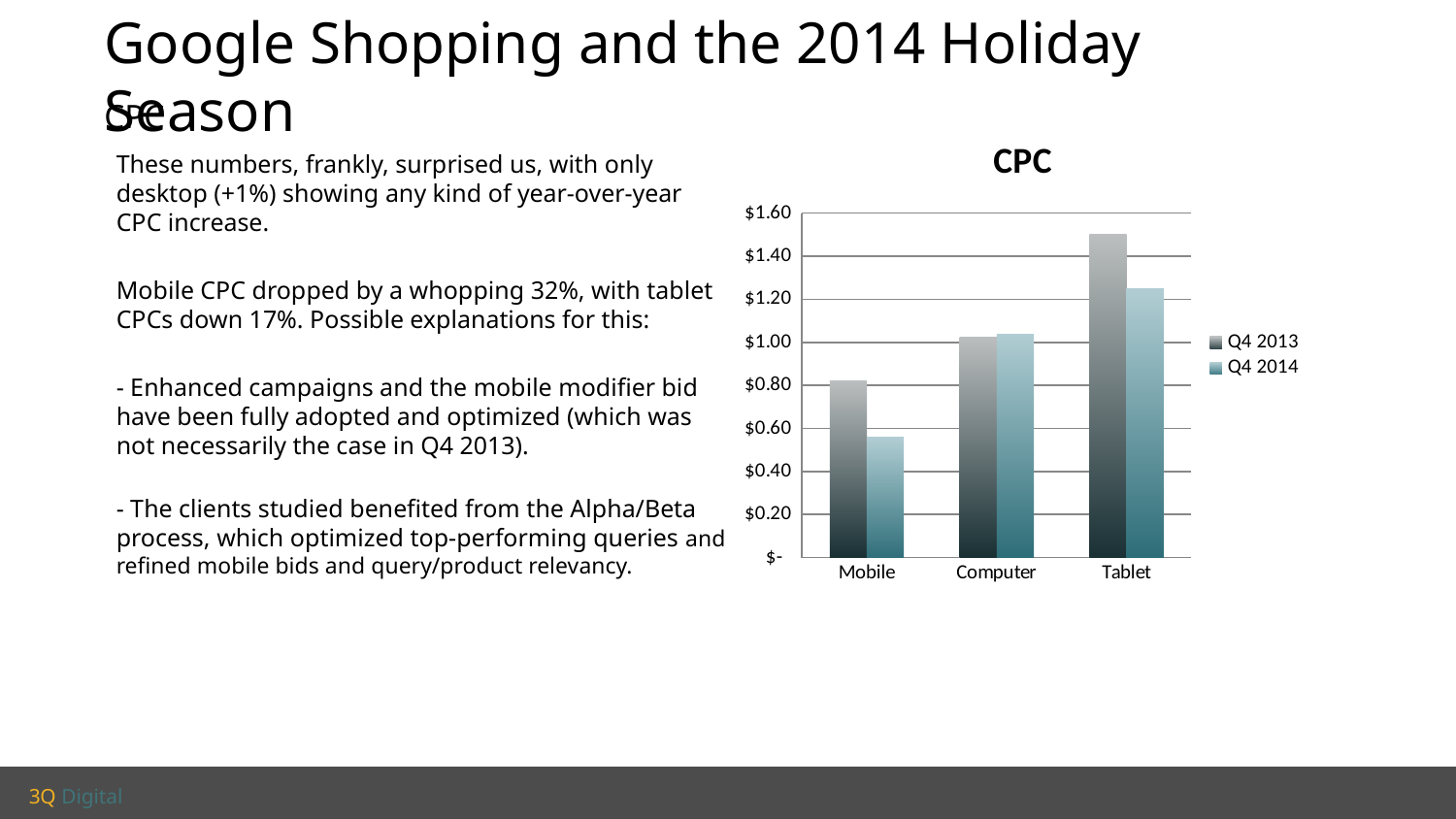
How many categories are shown on the x axis of the chart? 3 Which series are listed in the chart legend? Q4 2013 and Q4 2014 For Tablet, which is larger: the Q4 2013 CPC or the Q4 2014 CPC? Q4 2013 Is the Q4 2013 CPC for Computer greater or less than $0.80? greater Which category has the lowest Q4 2014 CPC? Mobile What type of chart is shown on the slide? bar chart What is the title of the chart? CPC Which category has the highest Q4 2013 CPC? Tablet How many series does the chart legend list? 2 For Mobile, which is larger: the Q4 2013 CPC or the Q4 2014 CPC? Q4 2013 Is the Q4 2013 CPC for Tablet greater or less than $1.40? greater Is the Q4 2014 CPC for Mobile greater or less than $0.80? less